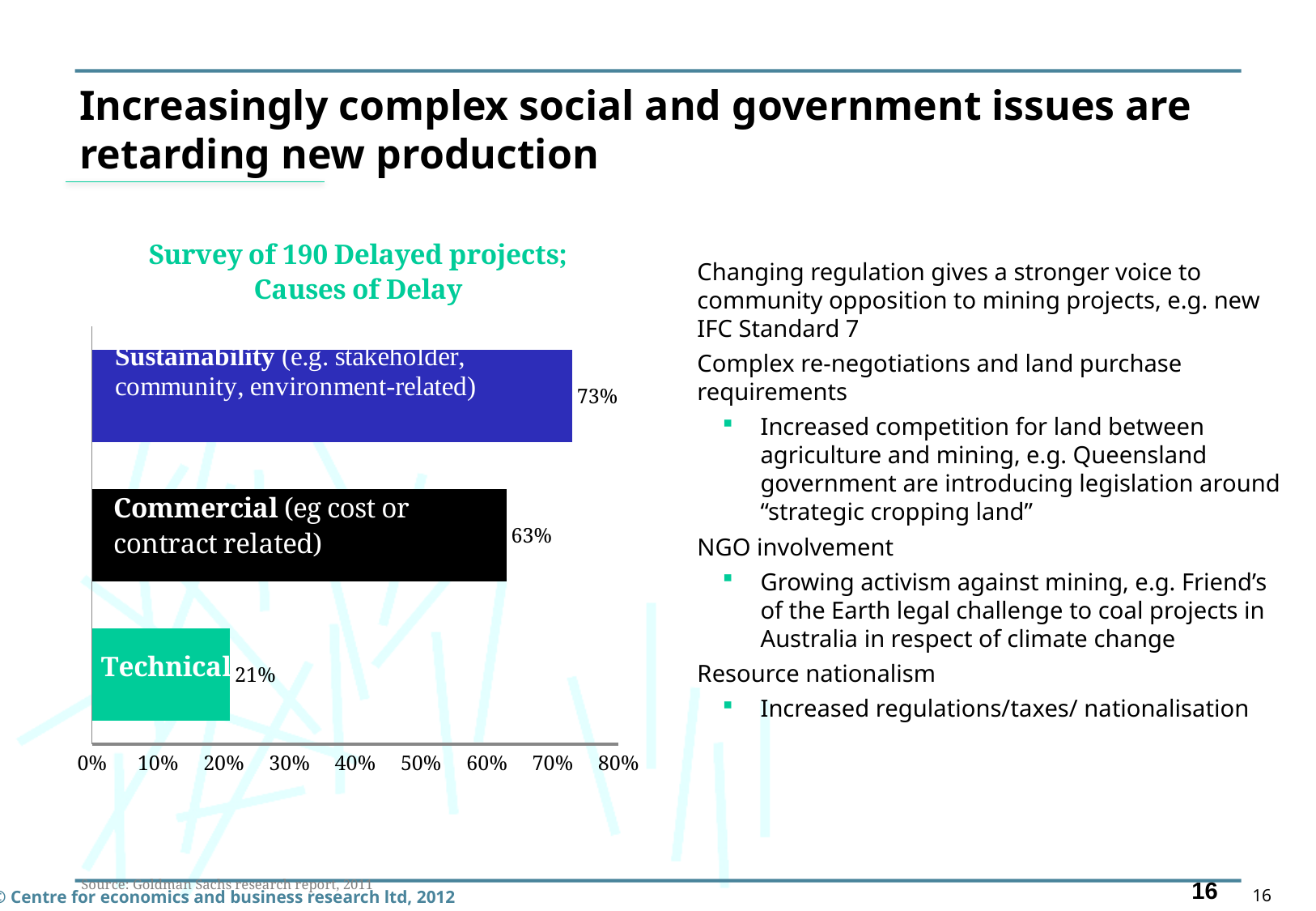
Which cause of delay has the highest percentage? Sustainability Which cause of delay has the lowest percentage? Technical Is the value for Sustainability greater or less than 70%? greater What is the difference in percentage points between Commercial and Technical? 42% What is the value shown for Commercial causes of delay? 63% Which is larger, the value for Commercial or the value for Technical? Commercial What kind of chart is used to show the causes of delay? Bar chart How many causes of delay are shown in the chart? 3 What percentage of delayed projects cite Sustainability as a cause of delay? 73% What is the difference in percentage points between Sustainability and Commercial? 10% What is the title of the chart? Survey of 190 Delayed projects; Causes of Delay What is the value shown for Technical causes of delay? 21%